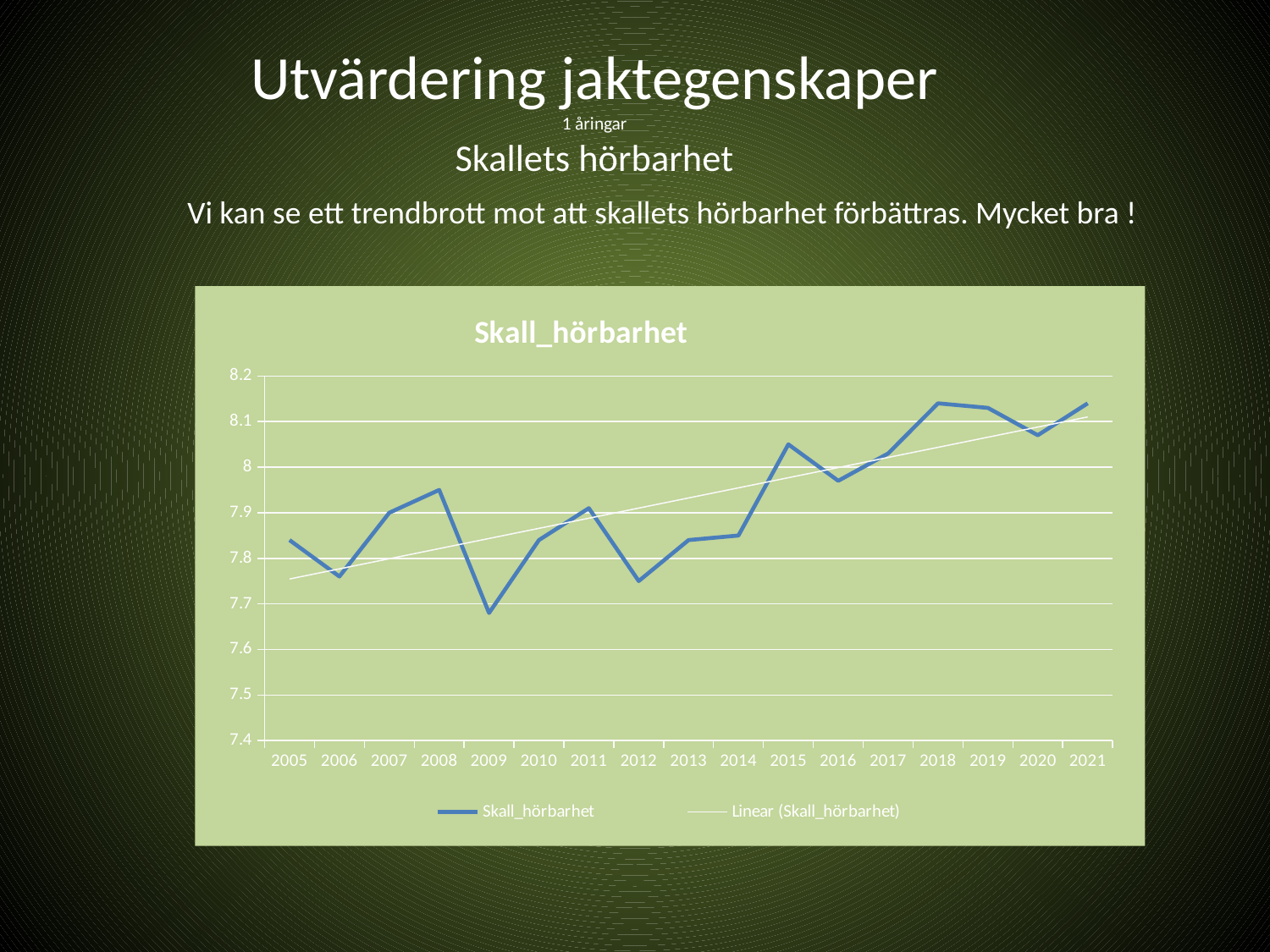
Does the Skall_hörbarhet value generally rise or fall from 2005 to 2021? rise How many years are plotted along the x axis? 17 Is the value for 2015 greater or less than 8? greater How many series does the chart legend list? 2 What kind of chart is shown on the slide? line chart Which year has the lowest value for Skall_hörbarhet? 2009 Is the value for 2018 greater or less than 8.1? greater Which year has the larger value, 2015 or 2016? 2015 Which year has the larger value, 2018 or 2020? 2018 Is the value for 2012 greater or less than 7.8? less What is the title of the chart? Skall_hörbarhet